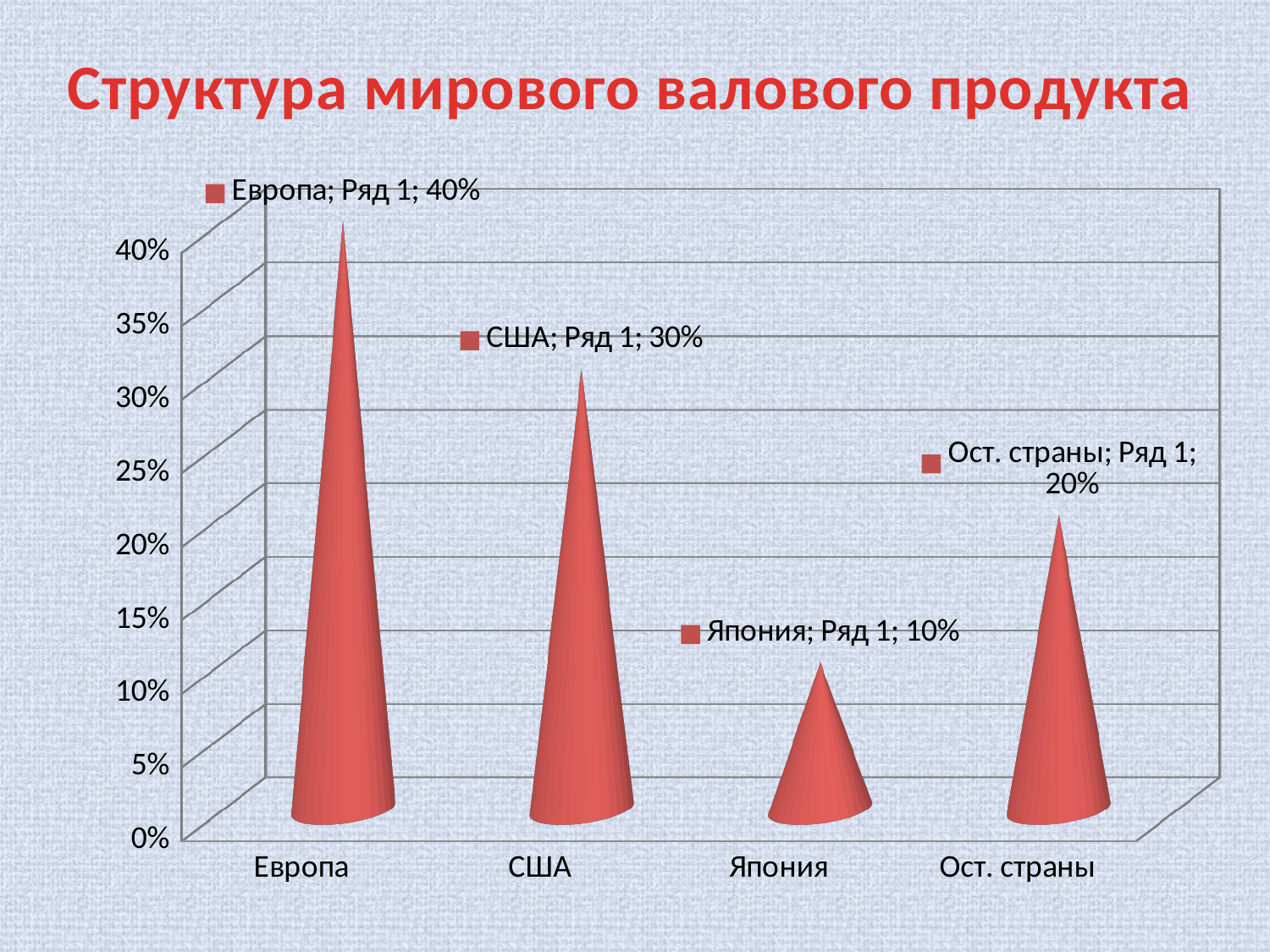
What is the value for США? 30% What kind of chart is shown on the slide? Bar chart Which category has the highest value? Европа What is the value for Япония? 10% What is the difference between the values for Европа and США? 10% What is the difference between the values for Ост. страны and Япония? 10% Which category has the lowest value? Япония How many categories are shown on the x axis? 4 Which is larger, the value for США or the value for Ост. страны? США What is the title of the chart on the slide? Структура мирового валового продукта What is the value for Европа? 40% What is the value for Ост. страны? 20%